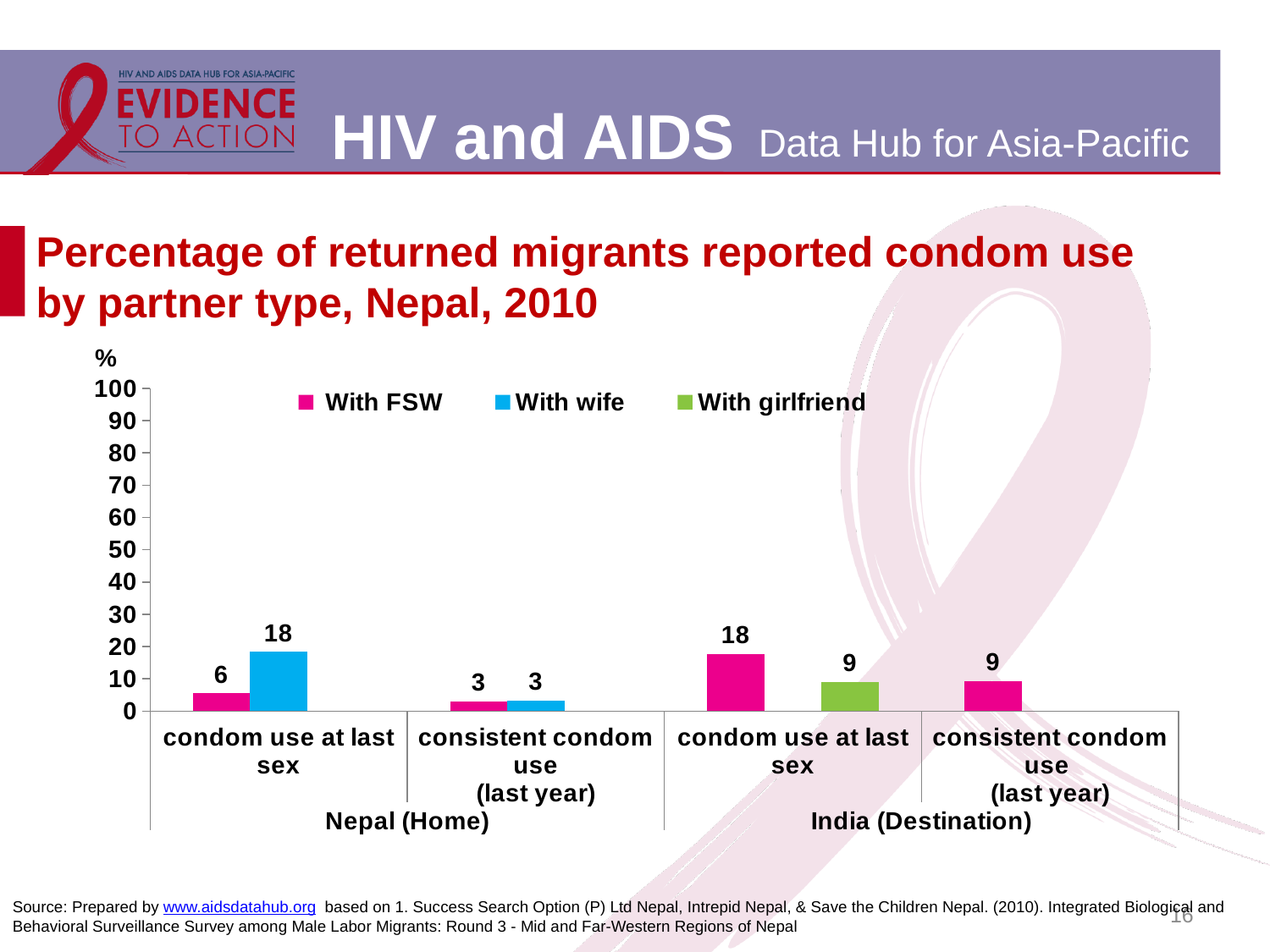
Which series is shown in pink in the legend? With FSW What percentage of returned migrants reported condom use at last sex with their wife in Nepal (Home)? 18 What is the value for condom use at last sex with girlfriend in India (Destination)? 9 Which is larger in India (Destination): condom use at last sex with FSW or with girlfriend? With FSW What kind of chart is shown on the slide? Bar chart What is the value for condom use at last sex with FSW in Nepal (Home)? 6 How many series does the legend list? 3 What is the value for consistent condom use (last year) with wife in Nepal (Home)? 3 Is the value for condom use at last sex with FSW in India (Destination) greater or less than 10? greater What is the value for consistent condom use (last year) with FSW in India (Destination)? 9 What is the difference between condom use at last sex with wife and with FSW in Nepal (Home)? 12 What is the difference between condom use at last sex with FSW in India (Destination) and in Nepal (Home)? 12